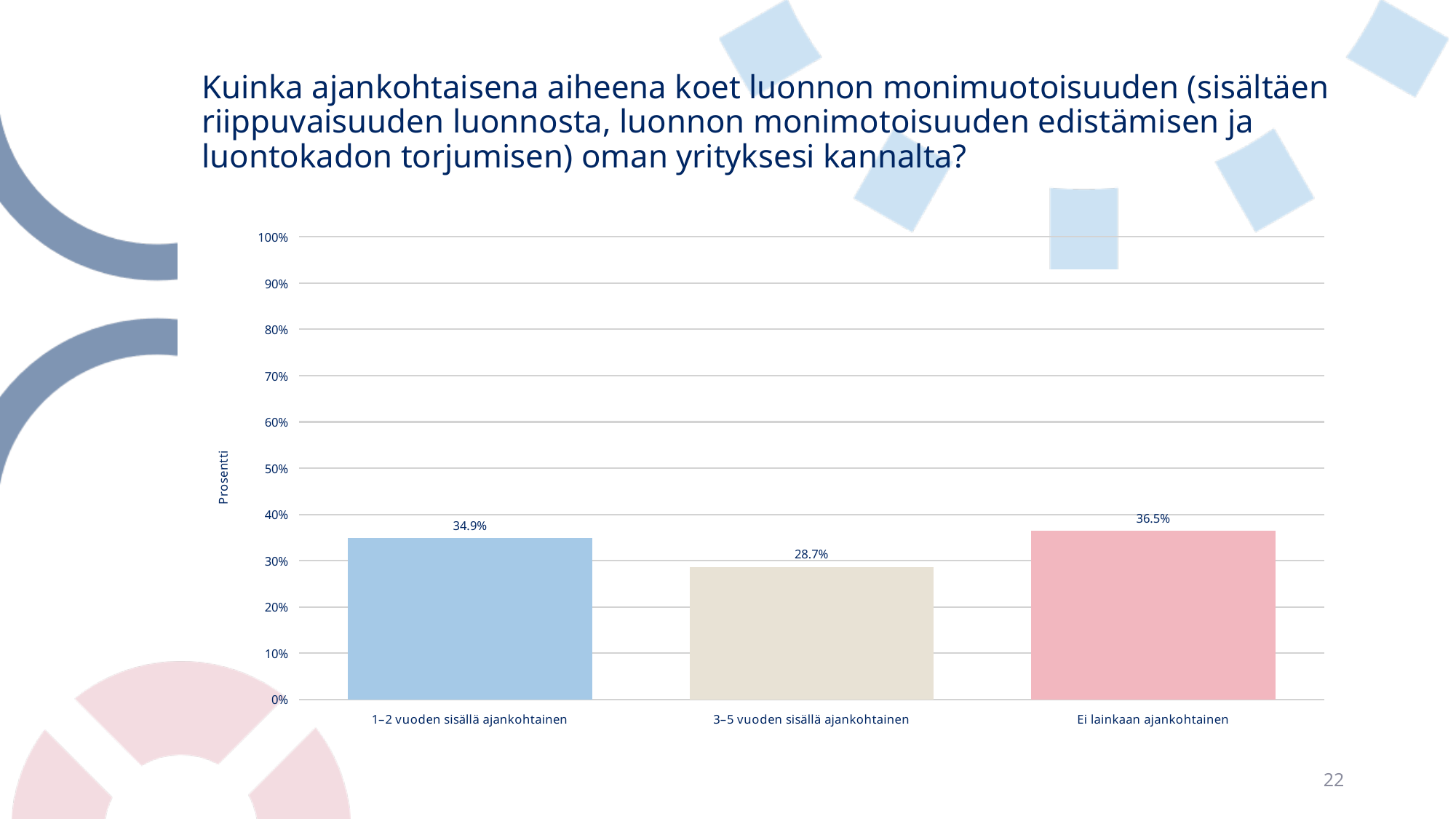
What is the value for "Ei lainkaan ajankohtainen"? 36.5% What is the difference between the values for "Ei lainkaan ajankohtainen" and "3–5 vuoden sisällä ajankohtainen"? 7.8% Which category has the lowest value? 3–5 vuoden sisällä ajankohtainen How many categories are shown on the x axis? 3 What is the label of the vertical axis? Prosentti What is the difference between the values for "1–2 vuoden sisällä ajankohtainen" and "3–5 vuoden sisällä ajankohtainen"? 6.2% What is the value for "3–5 vuoden sisällä ajankohtainen"? 28.7% What is the value for "1–2 vuoden sisällä ajankohtainen"? 34.9% Is the value for "3–5 vuoden sisällä ajankohtainen" greater or less than 30%? less Which is larger, the value for "1–2 vuoden sisällä ajankohtainen" or "3–5 vuoden sisällä ajankohtainen"? 1–2 vuoden sisällä ajankohtainen What kind of chart is shown on the slide? bar chart Which category has the highest value? Ei lainkaan ajankohtainen